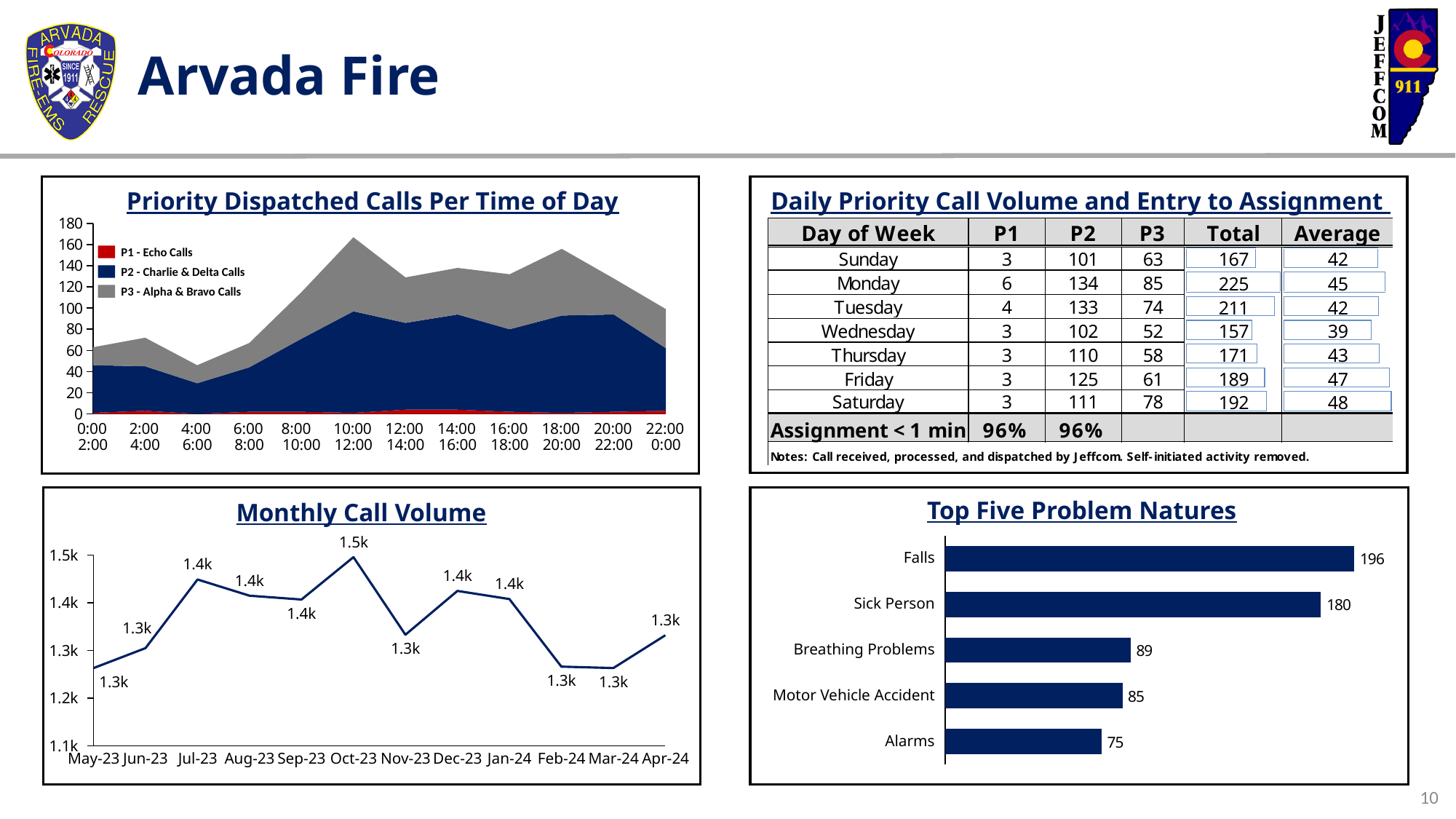
In the Top Five Problem Natures chart, which is larger: Breathing Problems or Motor Vehicle Accident? Breathing Problems In the Top Five Problem Natures chart, what is the value for Falls? 196 In the Top Five Problem Natures chart, which problem nature has the lowest value? Alarms How many months are plotted in the Monthly Call Volume chart? 12 In the Monthly Call Volume chart, which month has the highest call volume? Oct-23 In the Monthly Call Volume chart, what is the value for Oct-23? 1.5k In the Top Five Problem Natures chart, what is the value for Motor Vehicle Accident? 85 How many series does the legend of the Priority Dispatched Calls Per Time of Day chart list? 3 In the Priority Dispatched Calls Per Time of Day chart, is the total stacked value for the 10:00-12:00 period greater or less than 140? greater What kind of chart is the Top Five Problem Natures chart? Bar chart In the Priority Dispatched Calls Per Time of Day chart, which legend entry is shown in red? P1 - Echo Calls In the Top Five Problem Natures chart, what is the difference between Falls and Sick Person? 16